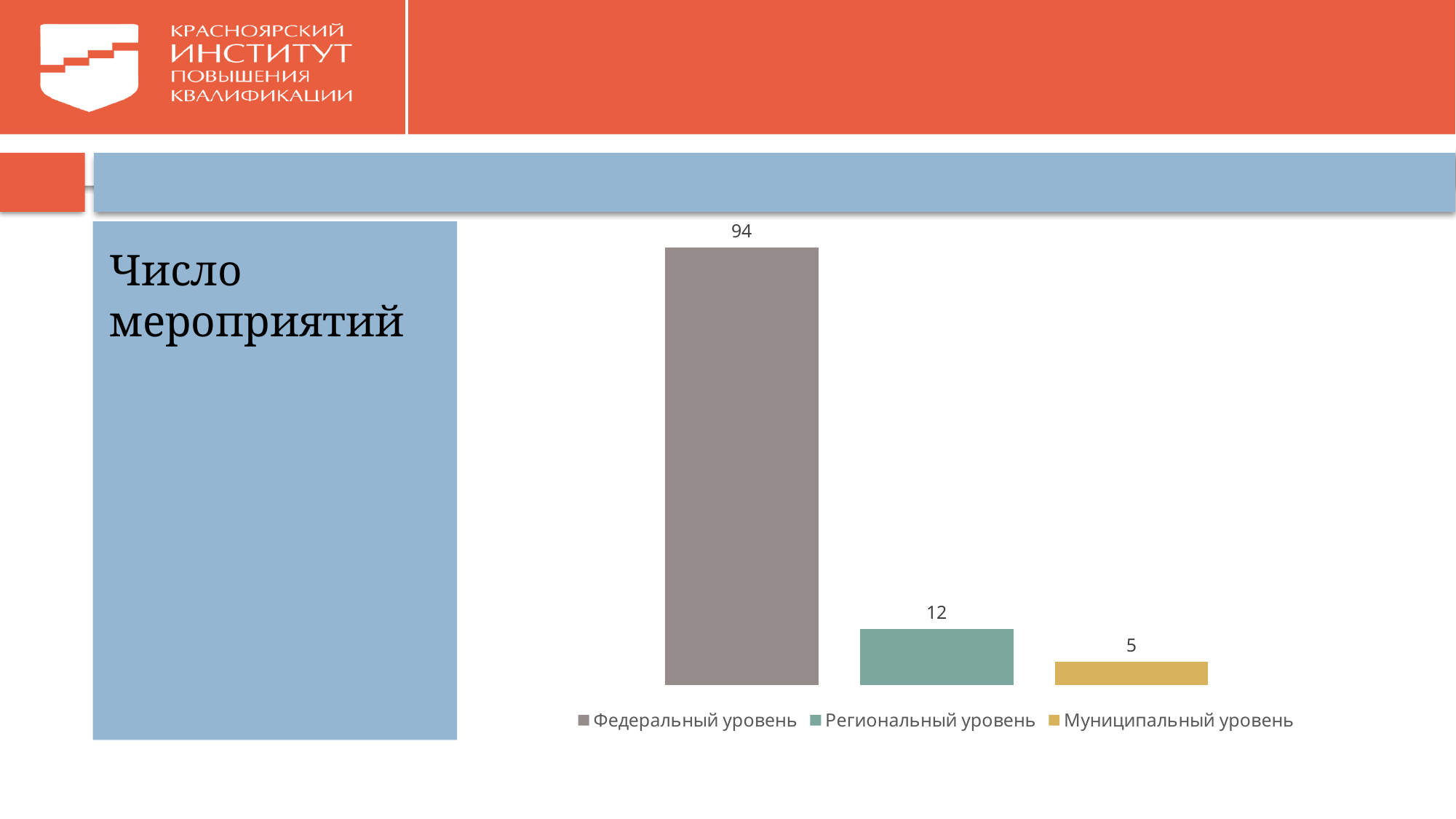
What is the value for Региональный уровень? 12 What is the difference between the values for Федеральный уровень and Региональный уровень? 82 Which is larger, the value for Региональный уровень or Муниципальный уровень? Региональный уровень What is the value for Муниципальный уровень? 5 What is the title text shown next to the chart? Число мероприятий What kind of chart is shown on the slide? Bar chart How many series does the legend list? 3 What is the value for Федеральный уровень? 94 Which level has the lowest number of events? Муниципальный уровень Which level has the highest number of events? Федеральный уровень How many bars are shown in the chart? 3 What is the difference between the values for Региональный уровень and Муниципальный уровень? 7